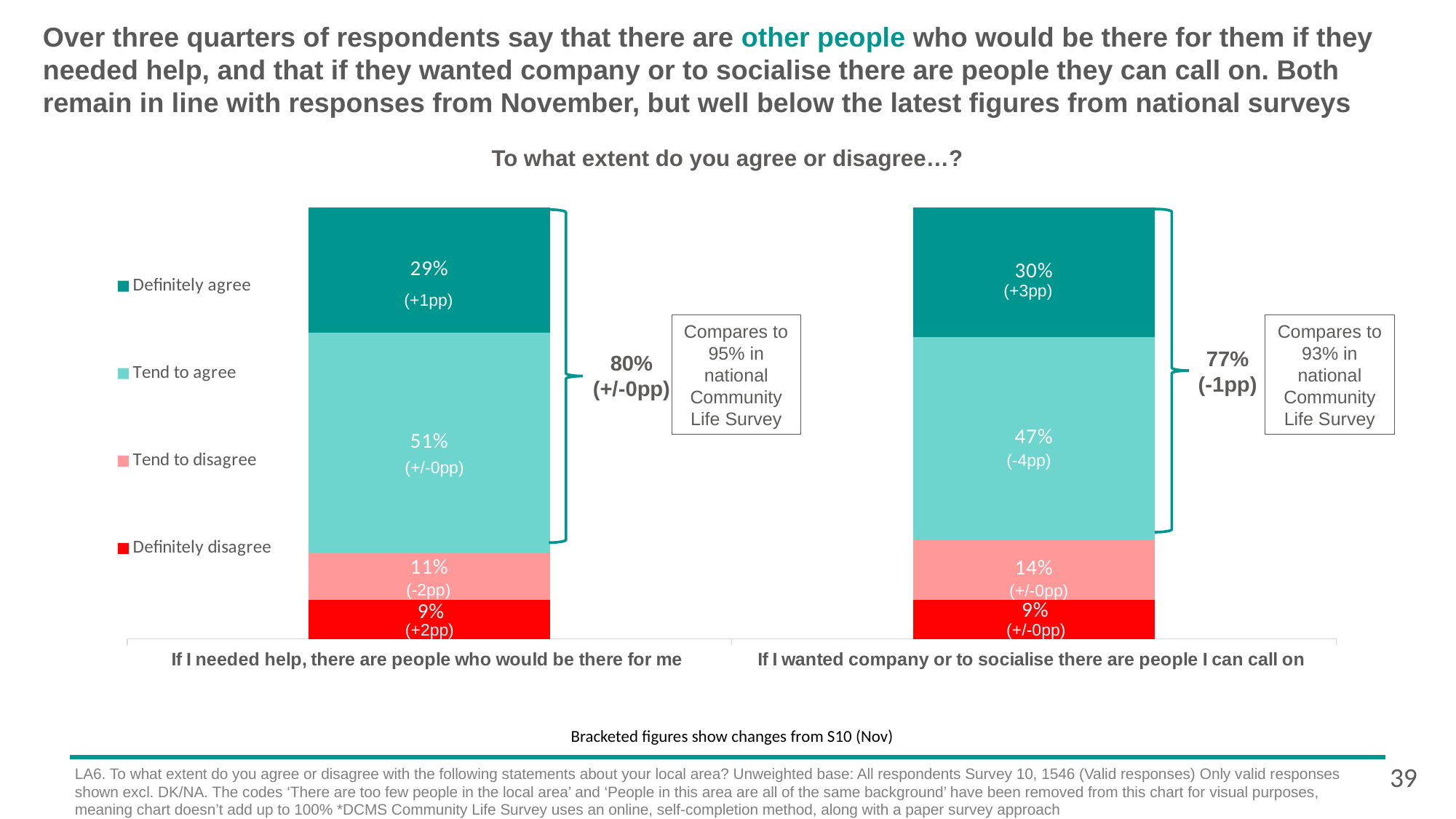
What is the combined percentage of 'Definitely agree' and 'Tend to agree' for 'If I needed help, there are people who would be there for me'? 80% How many series does the legend list? 4 Which statement has the larger 'Definitely agree' percentage? If I wanted company or to socialise there are people I can call on What is the change from November shown for 'Tend to agree' in the 'If I wanted company or to socialise there are people I can call on' bar? -4pp What percentage of respondents 'Tend to agree' with 'If I needed help, there are people who would be there for me'? 51% What is the title of the chart? To what extent do you agree or disagree…? What kind of chart is shown on the slide? Stacked bar chart Which response category is the largest segment in the bar for 'If I needed help, there are people who would be there for me'? Tend to agree What percentage of respondents 'Definitely agree' with 'If I wanted company or to socialise there are people I can call on'? 30% How many statements (bars) are plotted in the chart? 2 What is the difference in the 'Tend to agree' percentage between 'If I needed help, there are people who would be there for me' and 'If I wanted company or to socialise there are people I can call on'? 4 percentage points What percentage of respondents 'Tend to disagree' with 'If I wanted company or to socialise there are people I can call on'? 14%